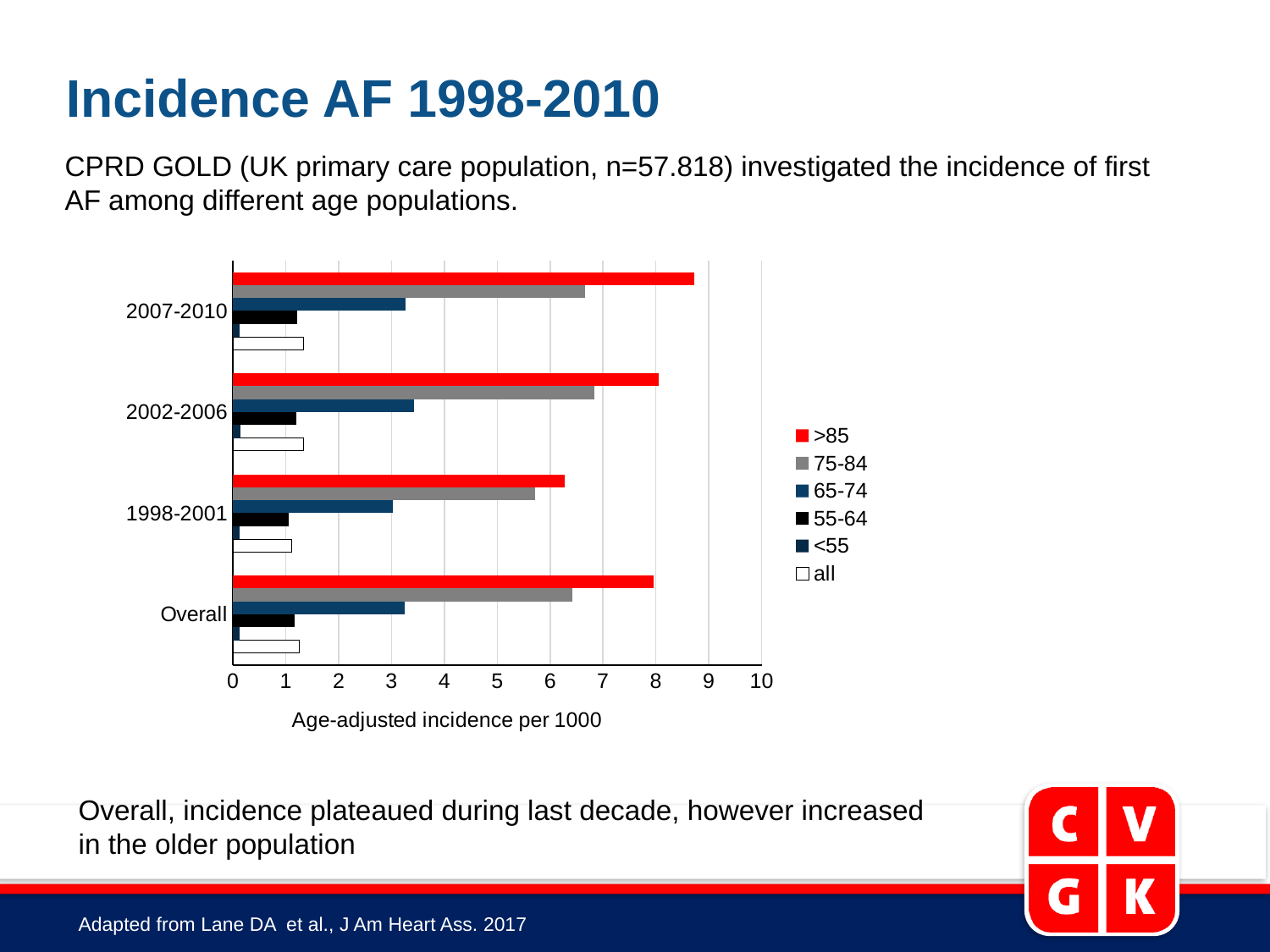
What kind of chart is shown on the slide? bar chart Which legend entry is shown in red? >85 Which age group has the highest incidence in the 2007-2010 period? >85 How many series does the legend list? 6 How many categories (time periods) are shown on the vertical axis? 4 Is the value for the 65-74 group in 2002-2006 greater or less than 3? greater Is the value for the >85 group in 2007-2010 greater or less than 8? greater Which is larger: the 75-84 value in 2002-2006 or the 65-74 value in 2002-2006? 75-84 What is the label of the horizontal axis? Age-adjusted incidence per 1000 Is the value for the >85 group in 1998-2001 greater or less than 7? less Which age group has the lowest incidence in the 1998-2001 period? <55 Which is larger: the >85 value in 2007-2010 or the >85 value in 1998-2001? 2007-2010